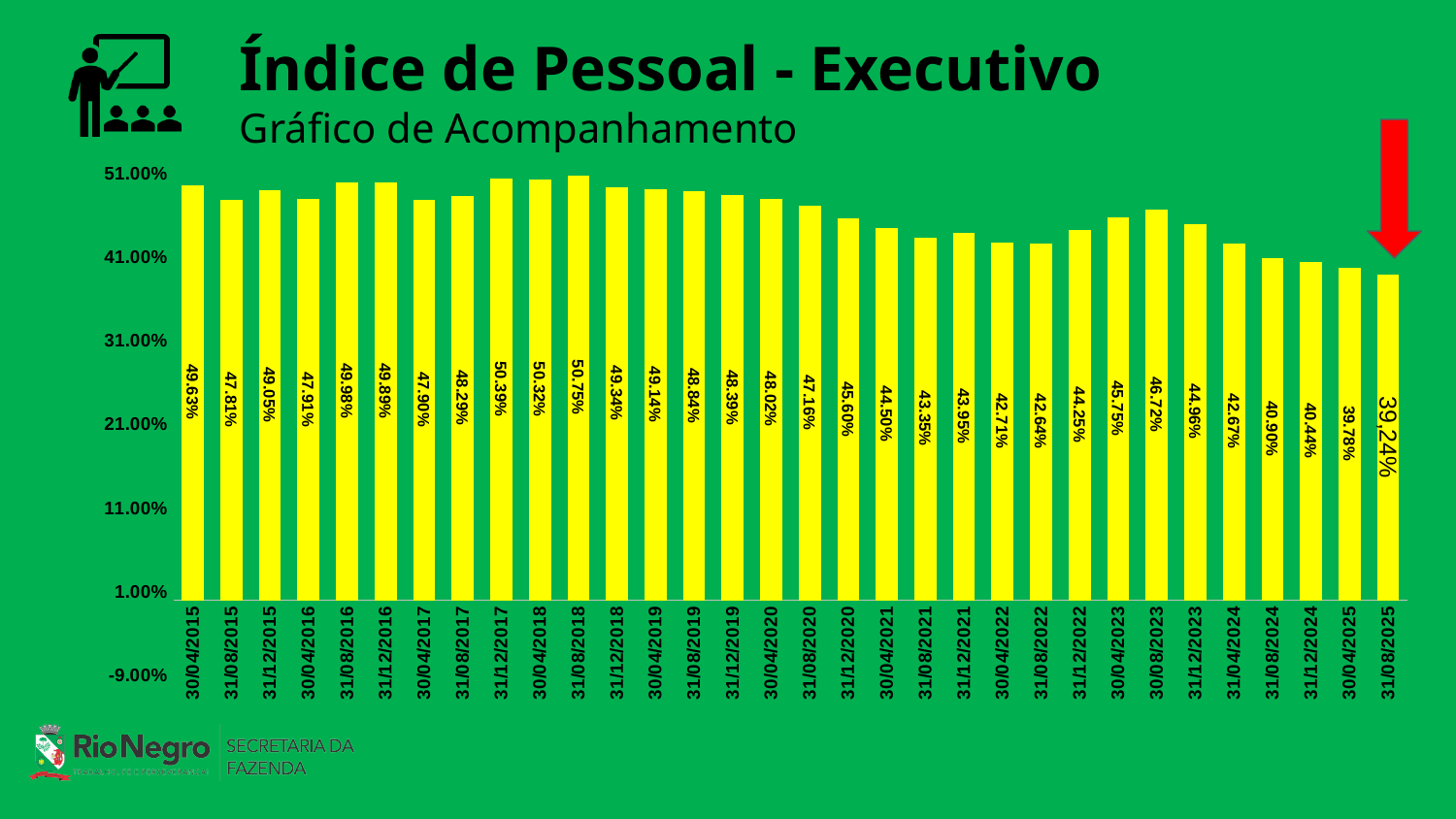
What is the value for 30/04/2015? 49.63% Which is larger, the value for 31/12/2021 or the value for 30/04/2022? 31/12/2021 Which date has the lowest value? 31/08/2025 What kind of chart is shown on the slide? Bar chart How many bars are plotted in the chart? 32 What is the difference between the values for 30/04/2015 and 31/08/2025? 10.39 percentage points Which date has the highest value? 31/08/2018 Is the value for 31/08/2024 greater or less than 41.00%? less Do the values generally rise or fall from 30/04/2015 to 31/08/2025? Fall What is the value for 31/08/2025? 39,24% What is the title of the chart? Índice de Pessoal - Executivo